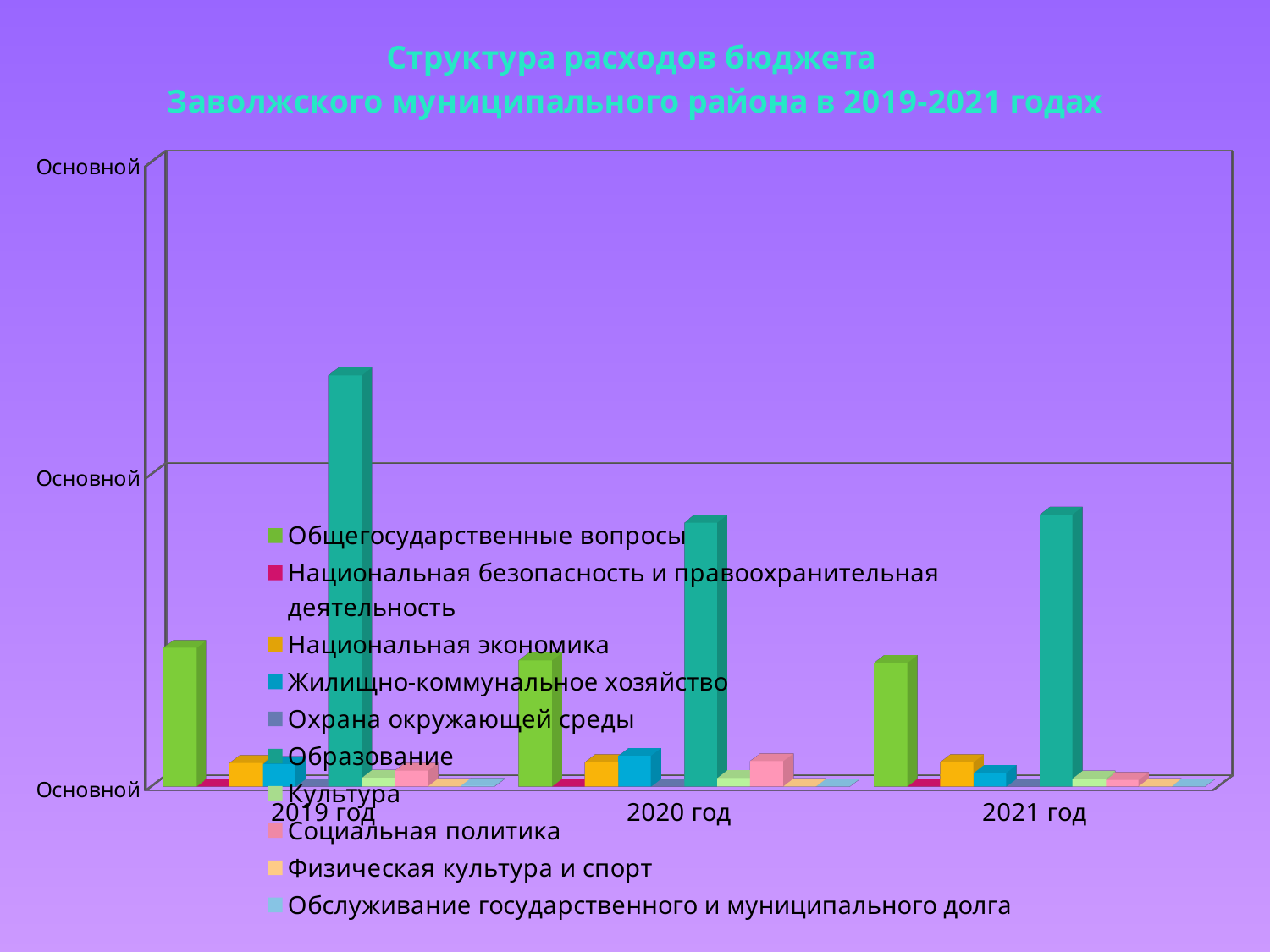
How many series does the legend list? 10 What is the title of the chart? Структура расходов бюджета Заволжского муниципального района в 2019-2021 годах Which expenditure category has the tallest bar in 2021 год? Образование Which series is shown in teal in the legend? Образование Which expenditure category has the tallest bar in 2019 год? Образование Which is larger in 2020 год: Общегосударственные вопросы or Национальная экономика? Общегосударственные вопросы Which is larger in 2019 год: Образование or Общегосударственные вопросы? Образование How many year categories are shown on the x axis? 3 Which is larger for Образование: 2019 год or 2020 год? 2019 год In which year is the bar for Образование the highest? 2019 год What kind of chart is shown on the slide? bar chart